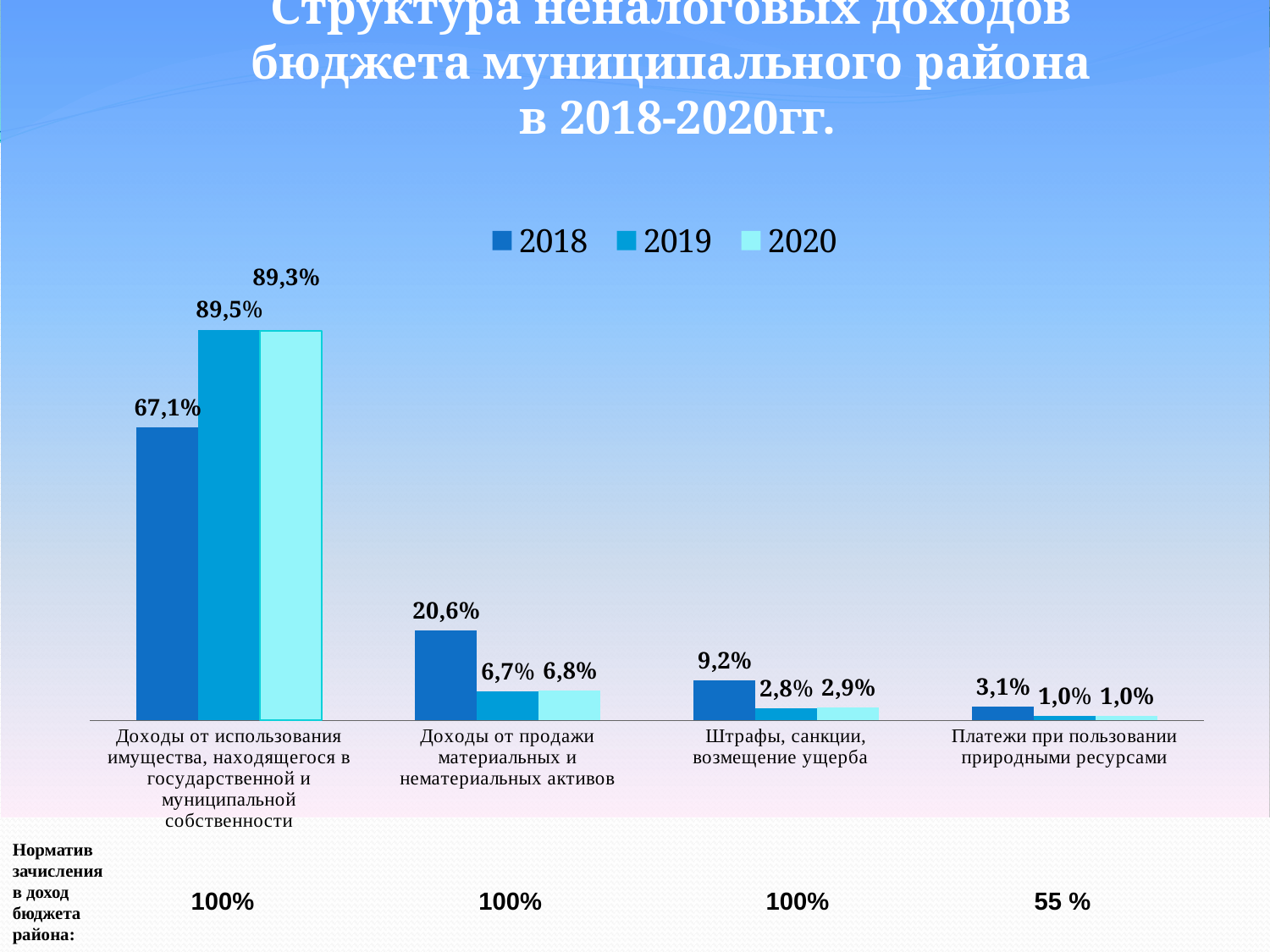
Which series is shown in the lightest colour in the legend? 2020 Which category has the lowest value in 2020? Платежи при пользовании природными ресурсами What is the difference between the 2019 and 2018 values for «Доходы от использования имущества, находящегося в государственной и муниципальной собственности»? 22,4% What is the 2020 value for «Штрафы, санкции, возмещение ущерба»? 2,9% How many series does the legend list? 3 What is the 2018 value for «Платежи при пользовании природными ресурсами»? 3,1% What is the 2018 value for «Доходы от использования имущества, находящегося в государственной и муниципальной собственности»? 67,1% What is the 2019 value for «Доходы от продажи материальных и нематериальных активов»? 6,7% What type of chart is shown on the slide? bar chart How many categories are shown on the x axis? 4 Which is larger for «Доходы от продажи материальных и нематериальных активов»: the 2018 value or the 2020 value? 2018 Which category has the highest value in 2019? Доходы от использования имущества, находящегося в государственной и муниципальной собственности